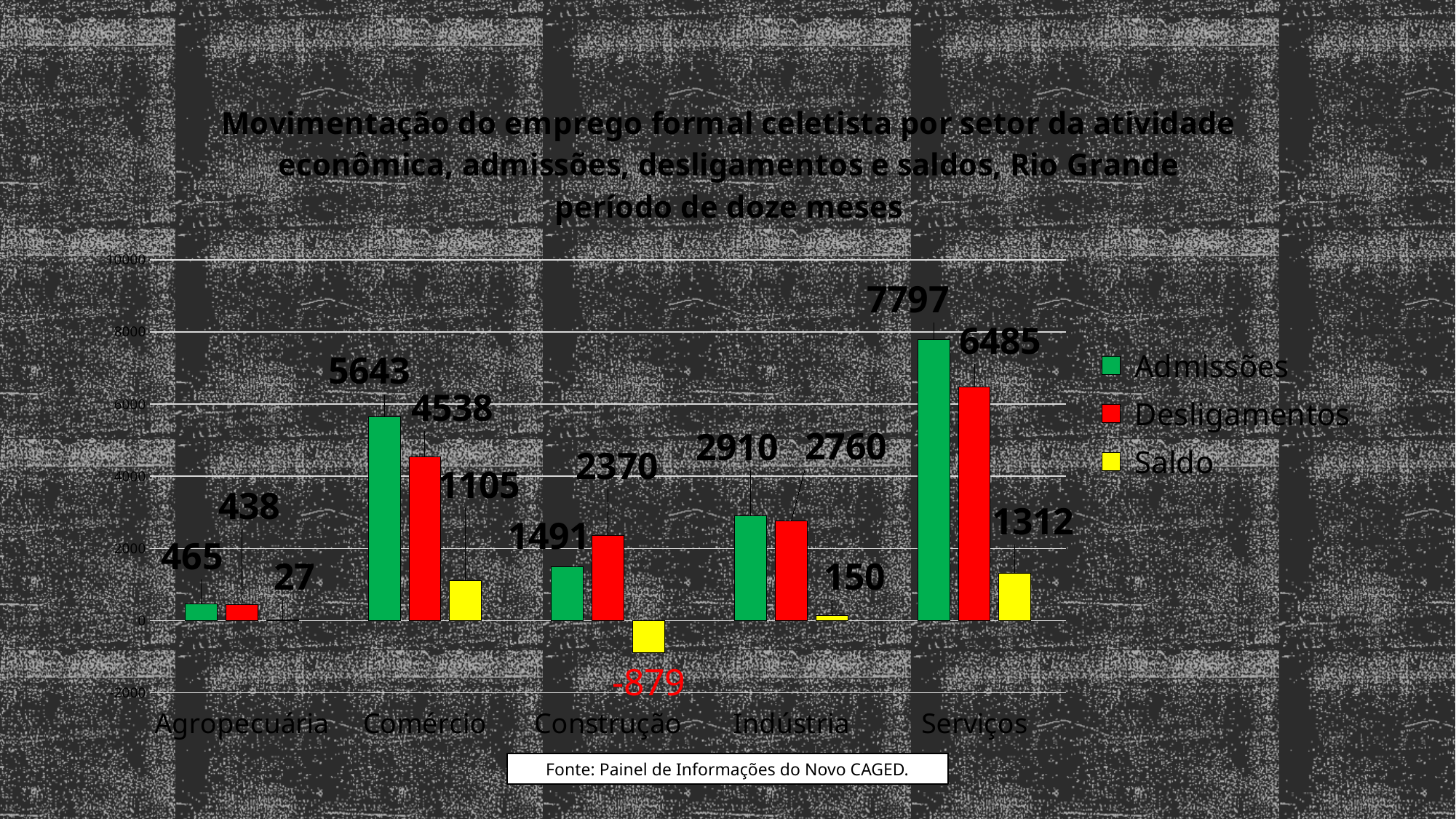
How many sectors are shown on the x axis? 5 What is the difference between Admissões and Desligamentos for Indústria? 150 How many series does the legend list? 3 What is the value of Desligamentos for Serviços? 6485 What is the value of Saldo for Construção? -879 Which is larger for Construção, Admissões or Desligamentos? Desligamentos Is the value of Admissões for Serviços greater or less than 6000? greater What kind of chart is shown on the slide? Bar chart What is the value of Admissões for Comércio? 5643 Which sector has the highest value of Admissões? Serviços What is the value of Saldo for Agropecuária? 27 Which sector has the lowest value of Saldo? Construção